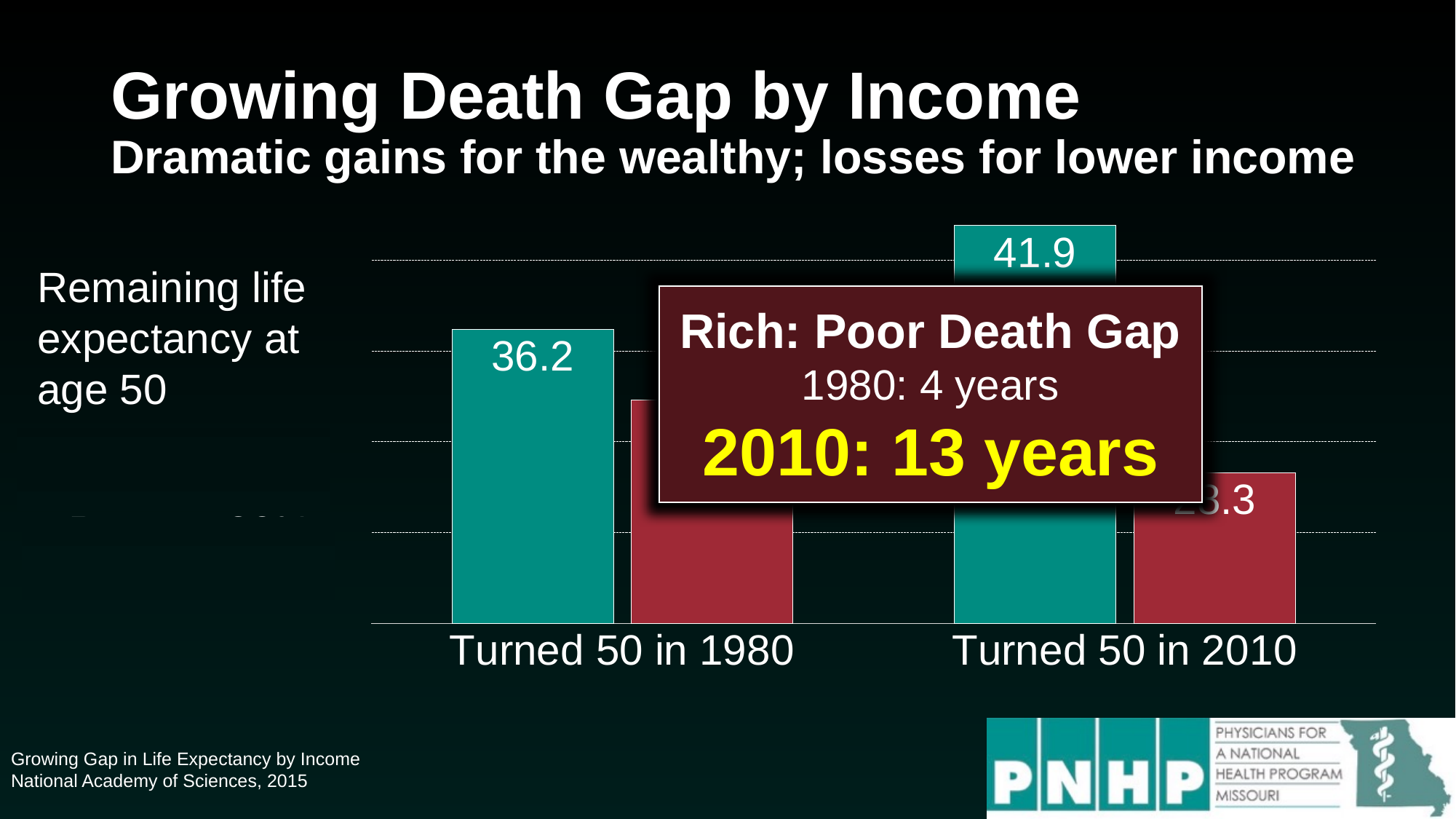
What type of chart is shown on the slide? bar chart Which teal bar is taller: "Turned 50 in 1980" or "Turned 50 in 2010"? Turned 50 in 2010 What quantity does the chart measure, according to the label to the left of the chart? Remaining life expectancy at age 50 What is the value of the teal bar for "Turned 50 in 2010"? 41.9 How many bars are plotted in total on the chart? 4 Do the teal bars rise or fall from "Turned 50 in 1980" to "Turned 50 in 2010"? rise What is the value of the teal bar for "Turned 50 in 1980"? 36.2 How many category groups are shown on the x axis? 2 What is the difference between the teal bar values for "Turned 50 in 2010" and "Turned 50 in 1980"? 5.7 Which bar on the chart has the highest value? the teal bar for Turned 50 in 2010 (41.9) In the "Turned 50 in 2010" group, which bar is taller, the teal bar or the red bar? the teal bar According to the overlay box on the chart, what was the rich-poor death gap in 2010? 13 years